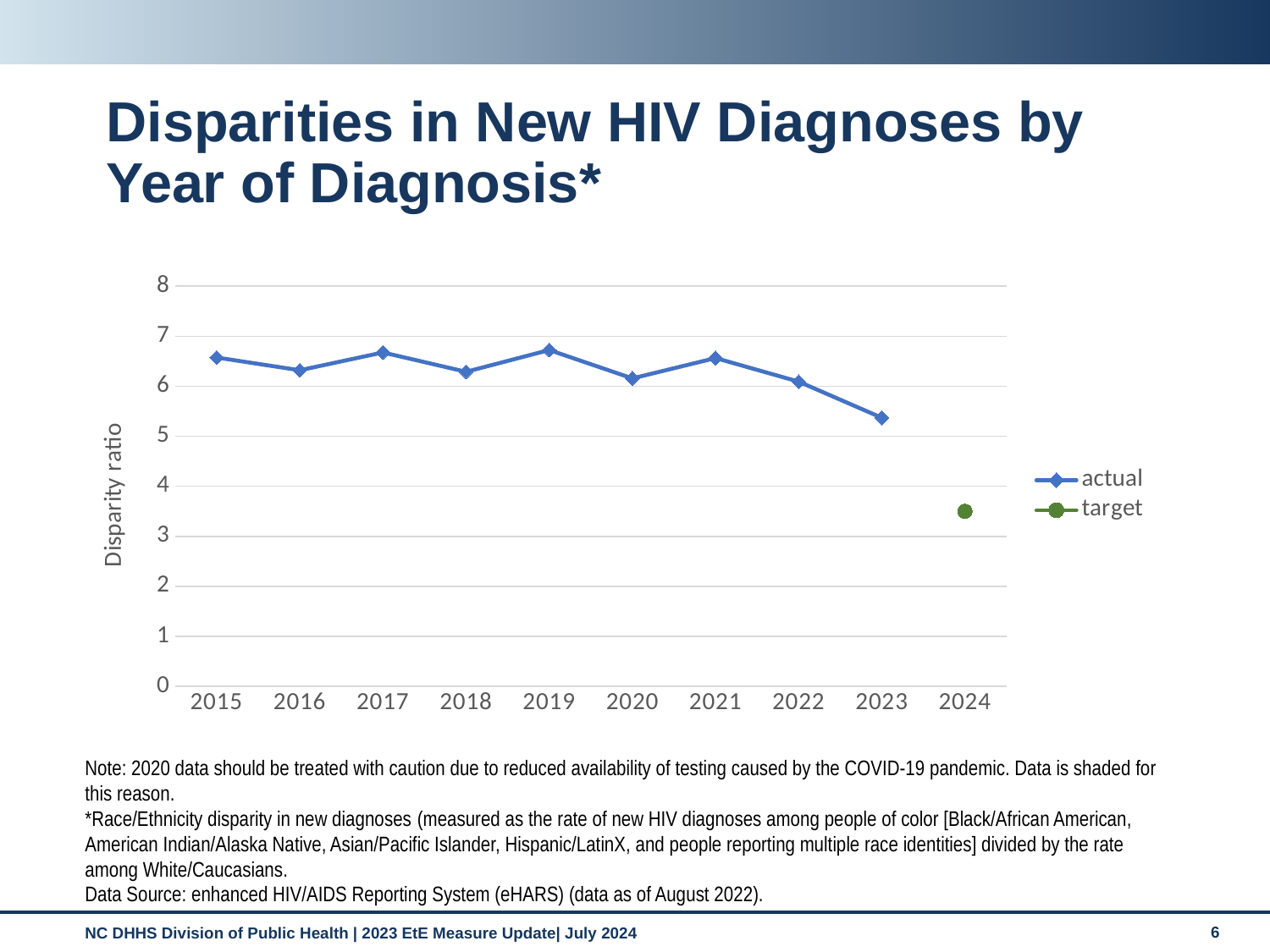
What are the two series named in the legend? actual and target Which year has the lowest value for the actual series? 2023 How many years are shown on the x axis? 10 Which is larger, the actual value for 2019 or the actual value for 2020? 2019 What is the label on the y axis? Disparity ratio Does the actual series rise or fall from 2021 to 2023? fall What kind of chart is shown on the slide? line chart Is the actual value for 2015 greater or less than 6? greater Is the target value for 2024 greater or less than 4? less Is the actual value for 2023 greater or less than 5? greater How many series does the legend list? 2